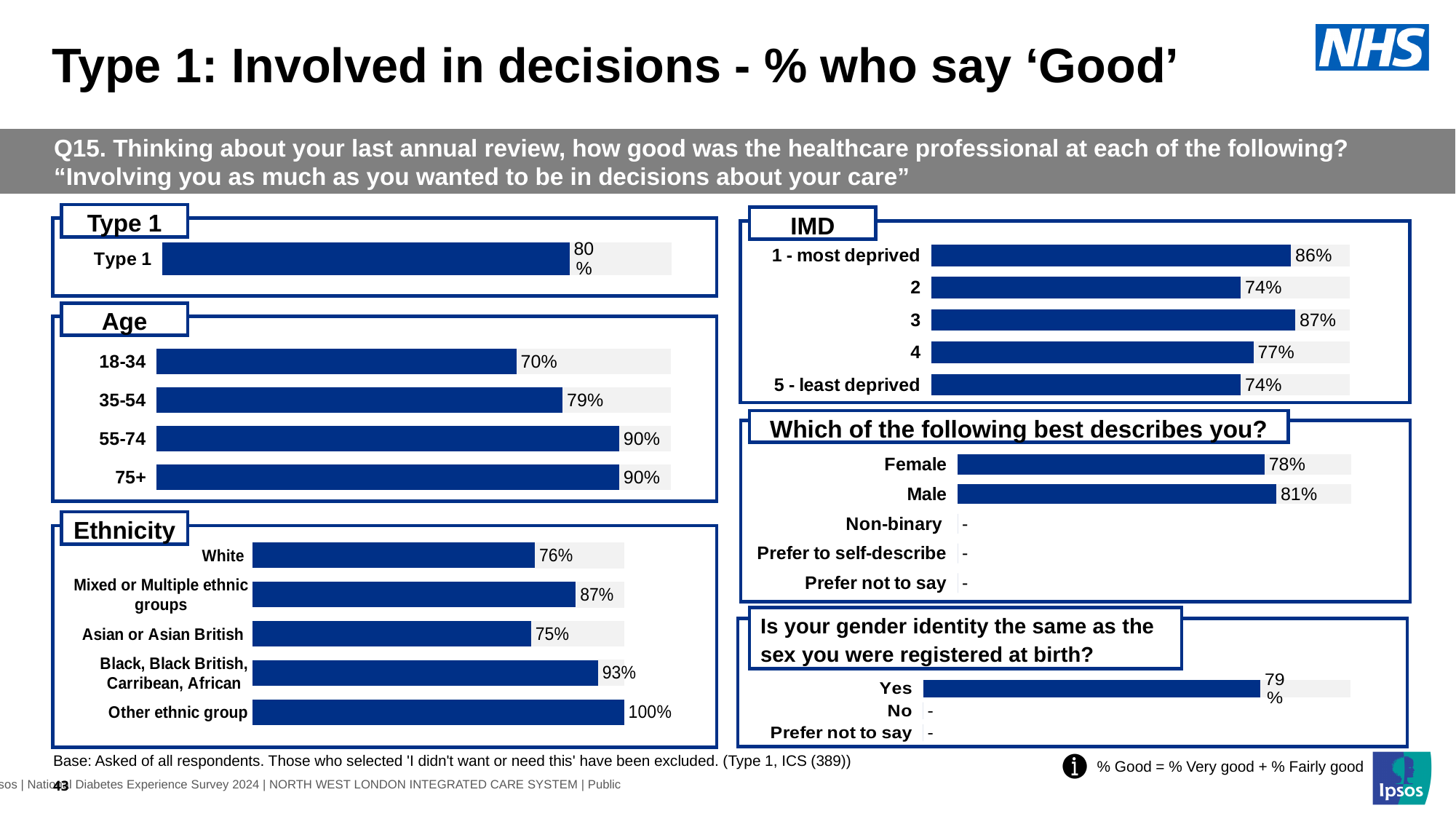
In the 'Which of the following best describes you?' chart, which is larger, Female or Male? Male In the IMD chart, which category has the highest value? 3 In the Type 1 chart, what is the value for Type 1? 80% In the IMD chart, what is the value for 4? 77% In the Ethnicity chart, what is the value for Asian or Asian British? 75% How many categories are shown in the IMD chart? 5 In the Age chart, what is the difference between the values for 55-74 and 18-34? 20% In the 'Is your gender identity the same as the sex you were registered at birth?' chart, what is the value for Yes? 79% In the Ethnicity chart, which category has the lowest value? Asian or Asian British In the Age chart, what is the value for 18-34? 70% What kind of chart is the Age chart? Bar chart In the Ethnicity chart, which category has the highest value? Other ethnic group